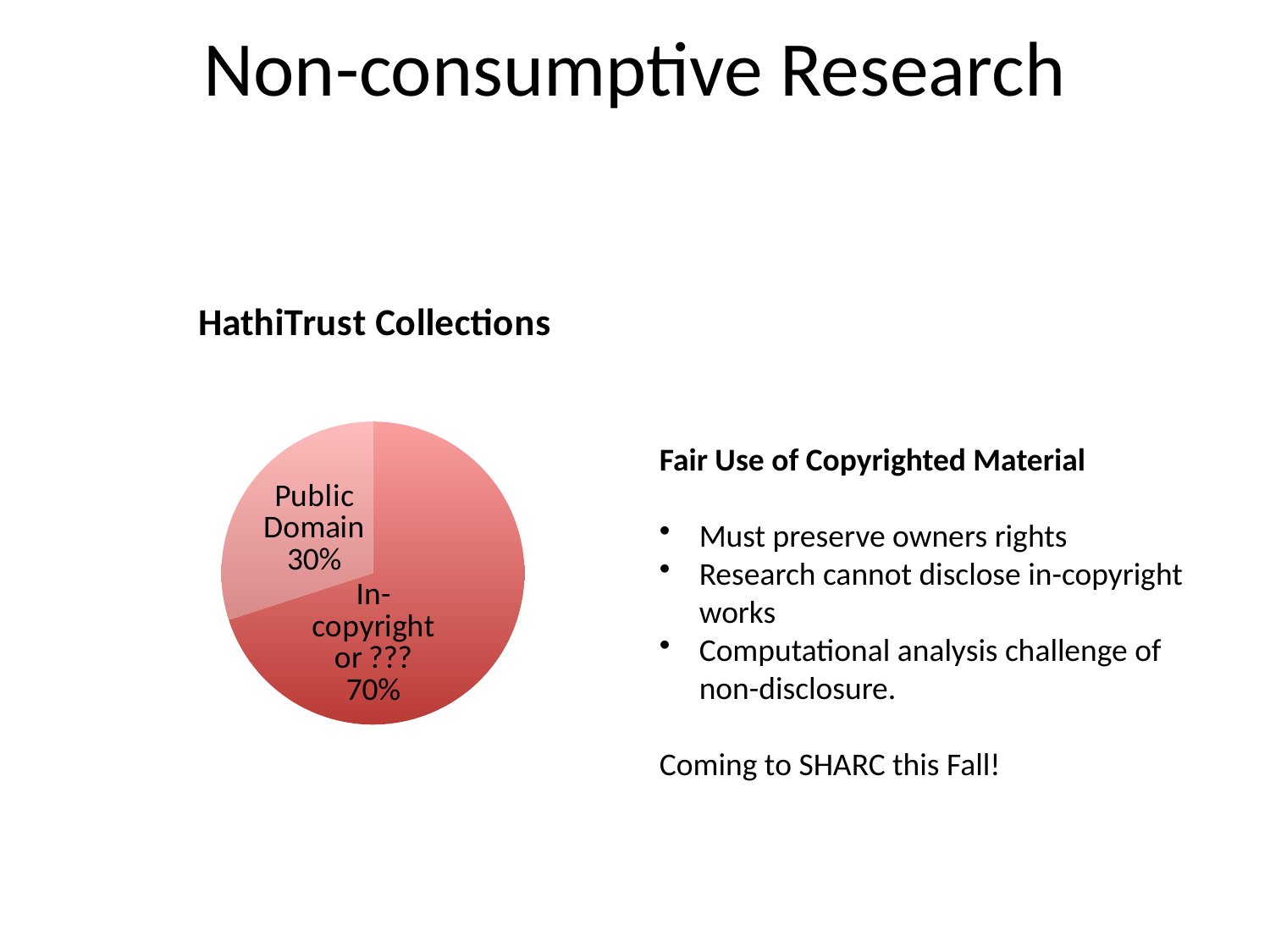
What is the title of the chart? HathiTrust Collections How many slices does the pie chart have? 2 Which slice of the pie is shown in the lighter pink colour? Public Domain Which slice of the pie is the smallest? Public Domain What is the difference in percentage points between the In-copyright or ??? slice and the Public Domain slice? 40 What share of the pie is In-copyright or ??? 70% Which slice of the pie is the largest? In-copyright or ??? What kind of chart is shown on the slide? pie chart What share of the pie is Public Domain? 30% Which is larger, the Public Domain slice or the In-copyright or ??? slice? In-copyright or ??? Is the Public Domain share greater or less than 50%? less